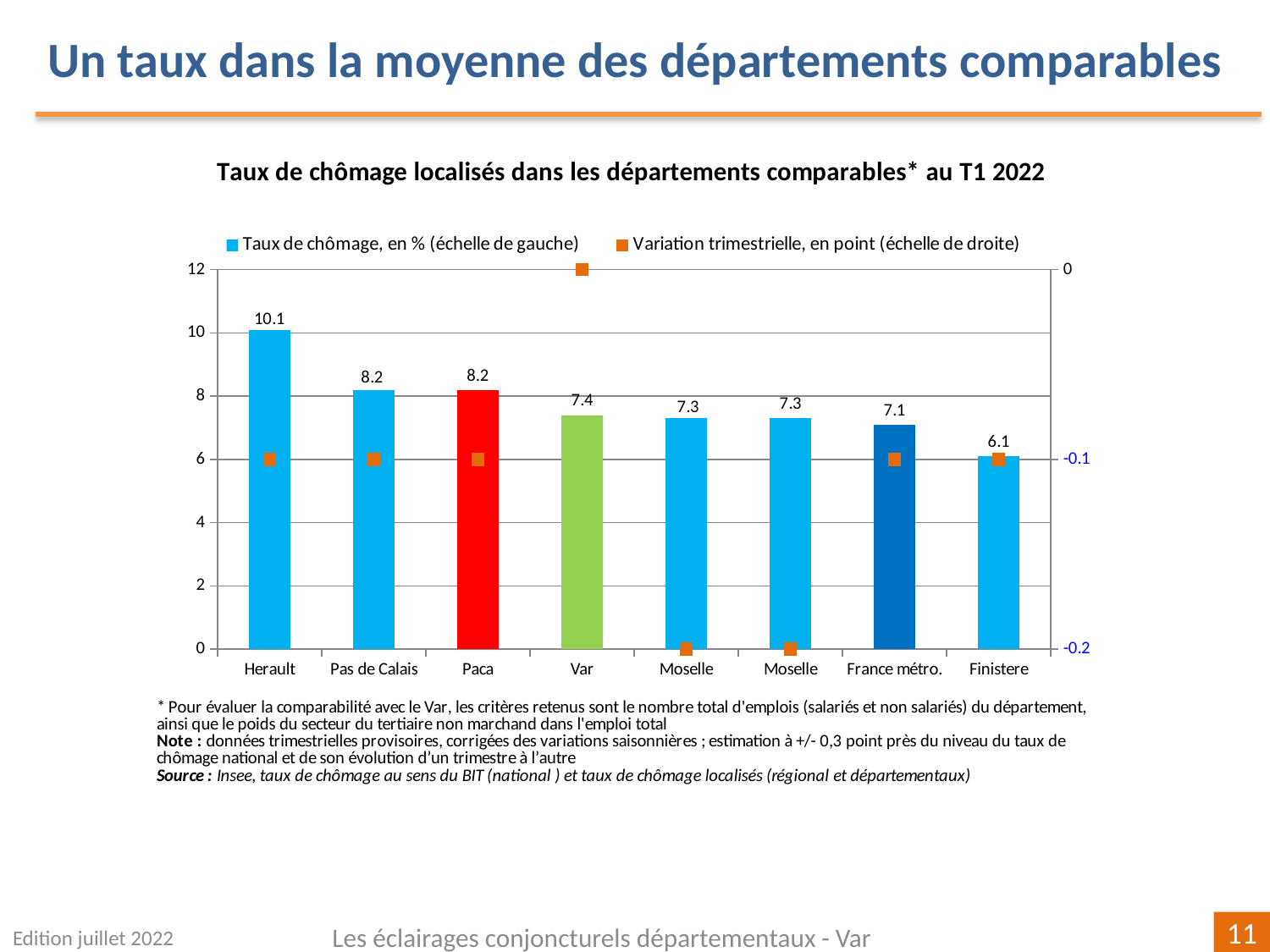
What is the unemployment rate shown for Var? 7.4 What is the quarterly variation (Variation trimestrielle) shown for Var on the right-hand axis? 0 What is the unemployment rate (Taux de chômage) shown for Herault? 10.1 What is the difference between the unemployment rates of Herault and Var? 2.7 What is the unemployment rate shown for France métro.? 7.1 Which category has the highest unemployment rate? Herault How many series does the legend list? 2 How many categories are shown on the x axis? 8 Which category has the lowest unemployment rate? Finistere Which has a higher unemployment rate, Pas de Calais or Var? Pas de Calais What kind of chart is this? Bar chart What is the unemployment rate shown for Finistere? 6.1